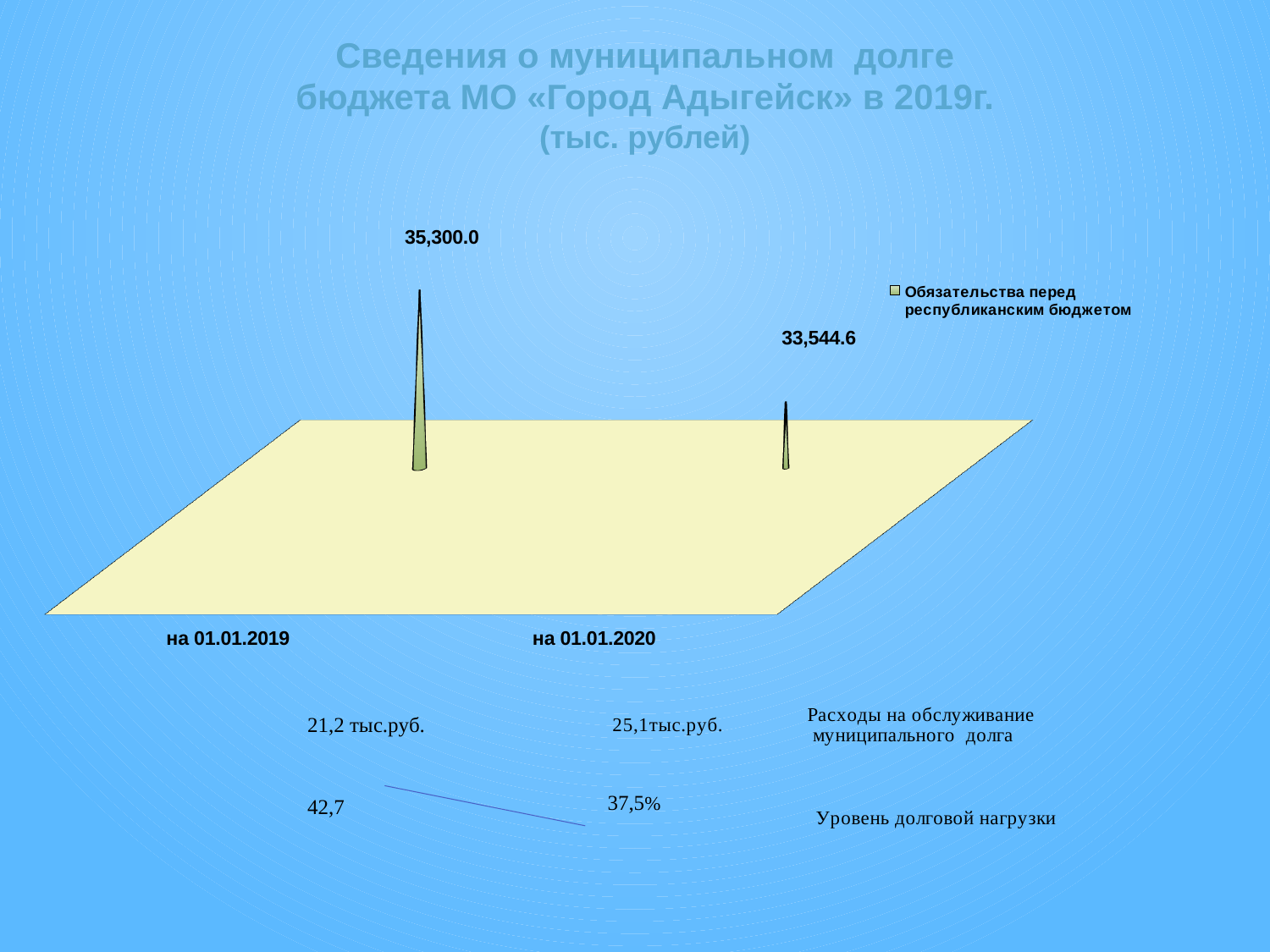
What series name is shown in the chart legend? Обязательства перед республиканским бюджетом How many categories are plotted on the chart? 2 Do the values rise or fall from «на 01.01.2019» to «на 01.01.2020»? fall Which category has the highest value? на 01.01.2019 What kind of chart is shown on the slide? bar chart Which is larger, the value for «на 01.01.2019» or for «на 01.01.2020»? на 01.01.2019 What unit is stated in the chart title? тыс. рублей What is the difference between the values for «на 01.01.2019» and «на 01.01.2020»? 1,755.4 What is the value for «на 01.01.2020»? 33,544.6 How many series does the legend list? 1 What is the value for «на 01.01.2019»? 35,300.0 Which category has the lowest value? на 01.01.2020